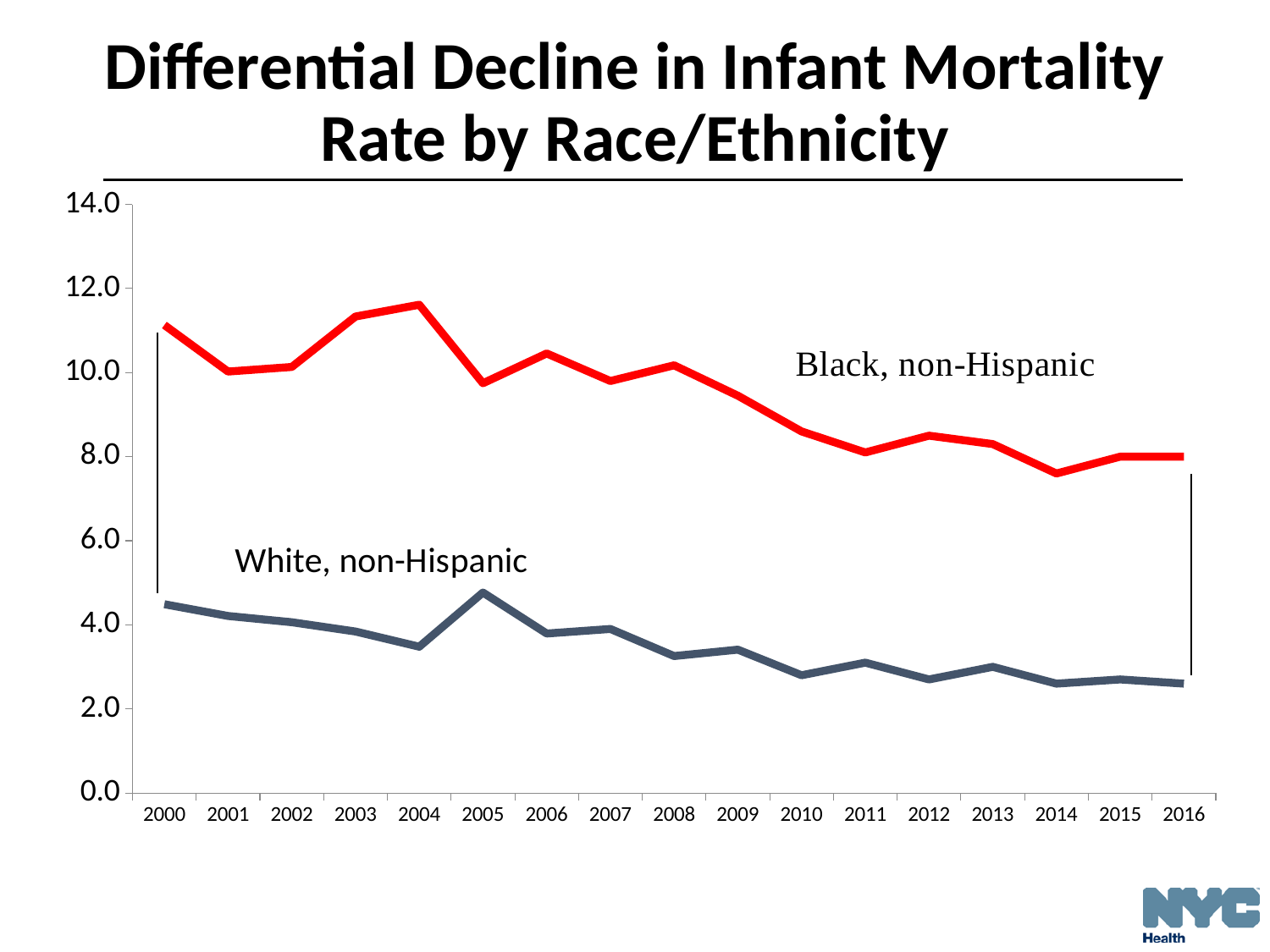
What is the first year shown on the x axis? 2000 Is the value for White, non-Hispanic in 2016 greater or less than 4.0? less Does the Black, non-Hispanic infant mortality rate generally rise or fall from 2000 to 2016? Fall Which series is drawn in red? Black, non-Hispanic How many years are shown along the x axis? 17 How many series are plotted on the chart? 2 Is the value for Black, non-Hispanic in 2010 greater or less than 10.0? less What kind of chart is shown on the slide? Line chart Is the value for Black, non-Hispanic in 2016 greater or less than 10.0? less Which series has the higher value in 2000, Black, non-Hispanic or White, non-Hispanic? Black, non-Hispanic